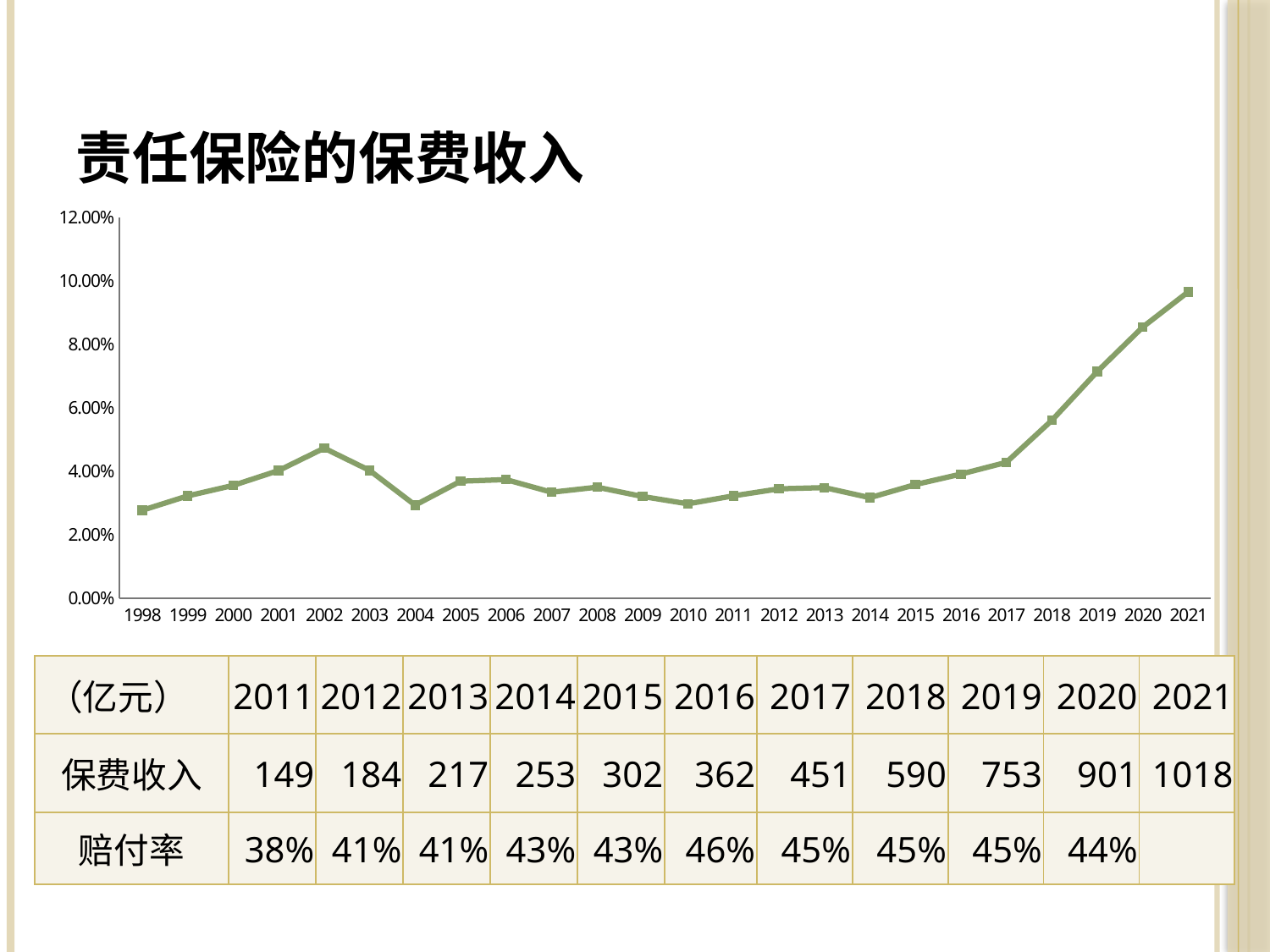
Is the value for 2004 greater or less than 4.00%? less What is the title of the slide containing the chart? 责任保险的保费收入 Is the value for 2019 greater or less than 6.00%? greater Is the value for 2018 greater or less than 4.00%? greater What kind of chart is shown on the slide? line chart Which year has the highest value on the chart? 2021 How many years are plotted on the x axis of the chart? 24 Which is larger, the value for 2019 or the value for 2017? 2019 Which is larger, the value for 2002 or the value for 2004? 2002 Do the values rise or fall from 2017 to 2021? rise